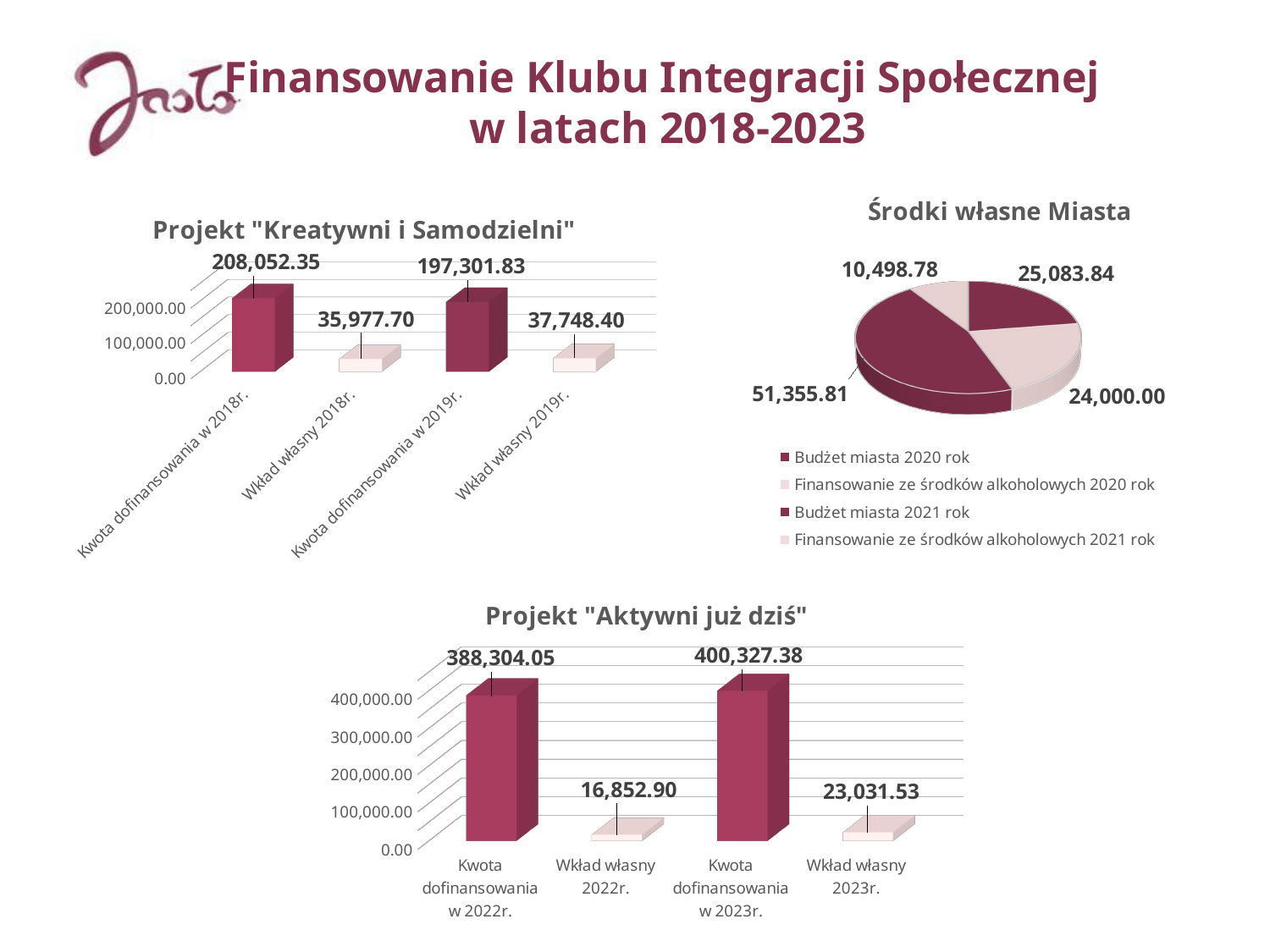
In the chart "Projekt "Aktywni już dziś"", how many categories are shown? 4 How many entries does the legend of the pie chart "Środki własne Miasta" list? 4 In the pie chart "Środki własne Miasta", what is the value for Budżet miasta 2021 rok? 51,355.81 In the chart "Projekt "Aktywni już dziś"", what is the value for Kwota dofinansowania w 2023r.? 400,327.38 In the chart "Projekt "Kreatywni i Samodzielni"", what is the value for Kwota dofinansowania w 2018r.? 208,052.35 In the chart "Projekt "Aktywni już dziś"", which category has the highest value? Kwota dofinansowania w 2023r. What kind of chart is "Środki własne Miasta"? Pie chart In the chart "Projekt "Kreatywni i Samodzielni"", what is the difference between Kwota dofinansowania w 2018r. and Kwota dofinansowania w 2019r.? 10,750.52 In the chart "Projekt "Kreatywni i Samodzielni"", which category has the lowest value? Wkład własny 2018r. In the chart "Projekt "Kreatywni i Samodzielni"", what is the value for Wkład własny 2019r.? 37,748.40 In the pie chart "Środki własne Miasta", which is larger: Budżet miasta 2020 rok or Finansowanie ze środków alkoholowych 2021 rok? Budżet miasta 2020 rok In the chart "Projekt "Aktywni już dziś"", what is the difference between Wkład własny 2023r. and Wkład własny 2022r.? 6,178.63